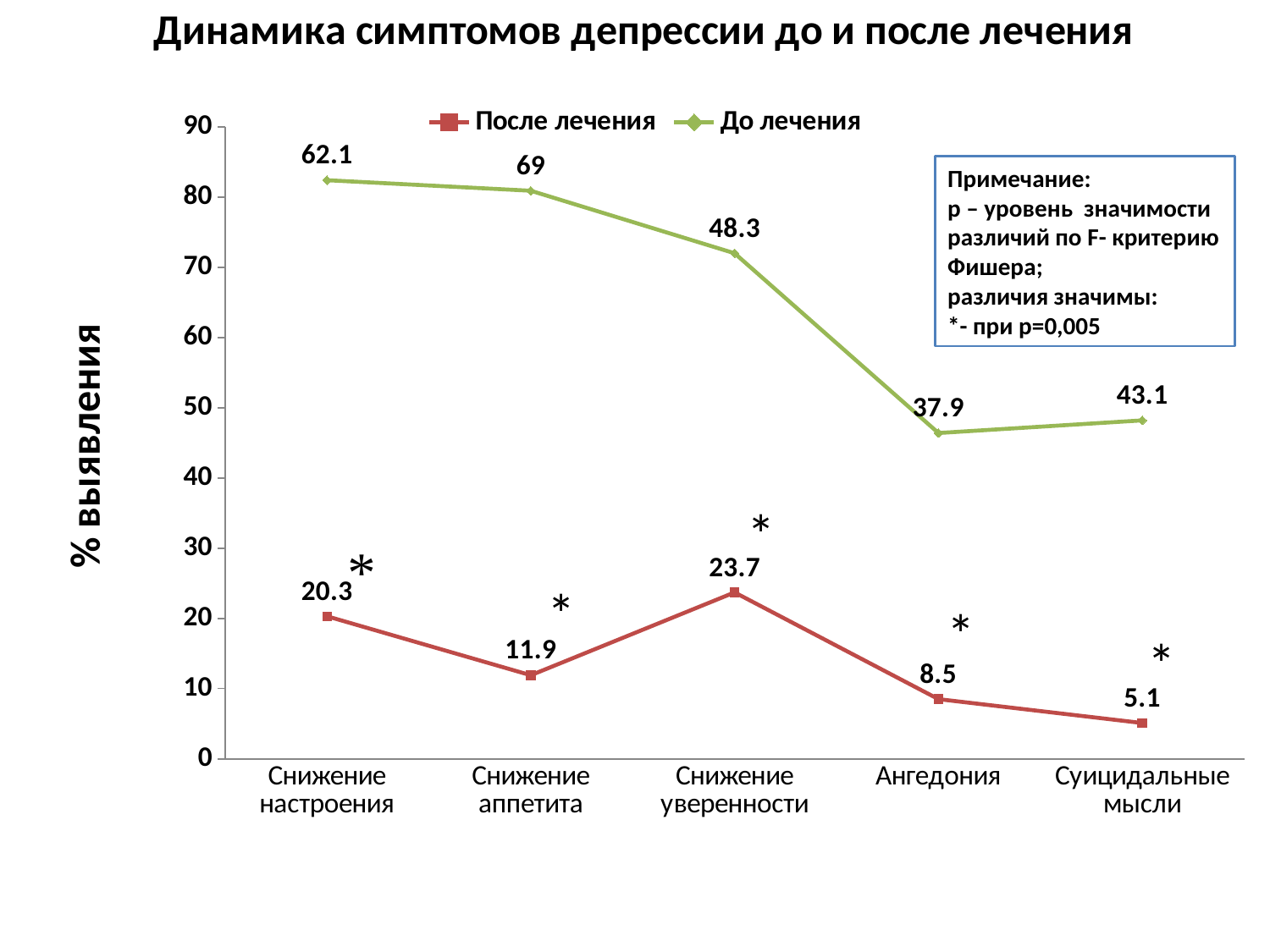
How many symptom categories are shown on the x axis? 5 Which category has the highest value for "После лечения"? Снижение уверенности What is the value for "До лечения" at "Снижение аппетита"? 69 Which is larger for "Снижение аппетита": the value for "До лечения" or for "После лечения"? До лечения What is the value for "После лечения" at "Снижение настроения"? 20.3 Which category has the lowest value for "После лечения"? Суицидальные мысли Is the value for "После лечения" at "Ангедония" greater or less than 10? less What is the value for "После лечения" at "Суицидальные мысли"? 5.1 How many series does the legend list? 2 What is the difference between the "После лечения" values for "Снижение уверенности" and "Ангедония"? 15.2 What type of chart is shown on the slide? line chart What is the value for "До лечения" at "Ангедония"? 37.9